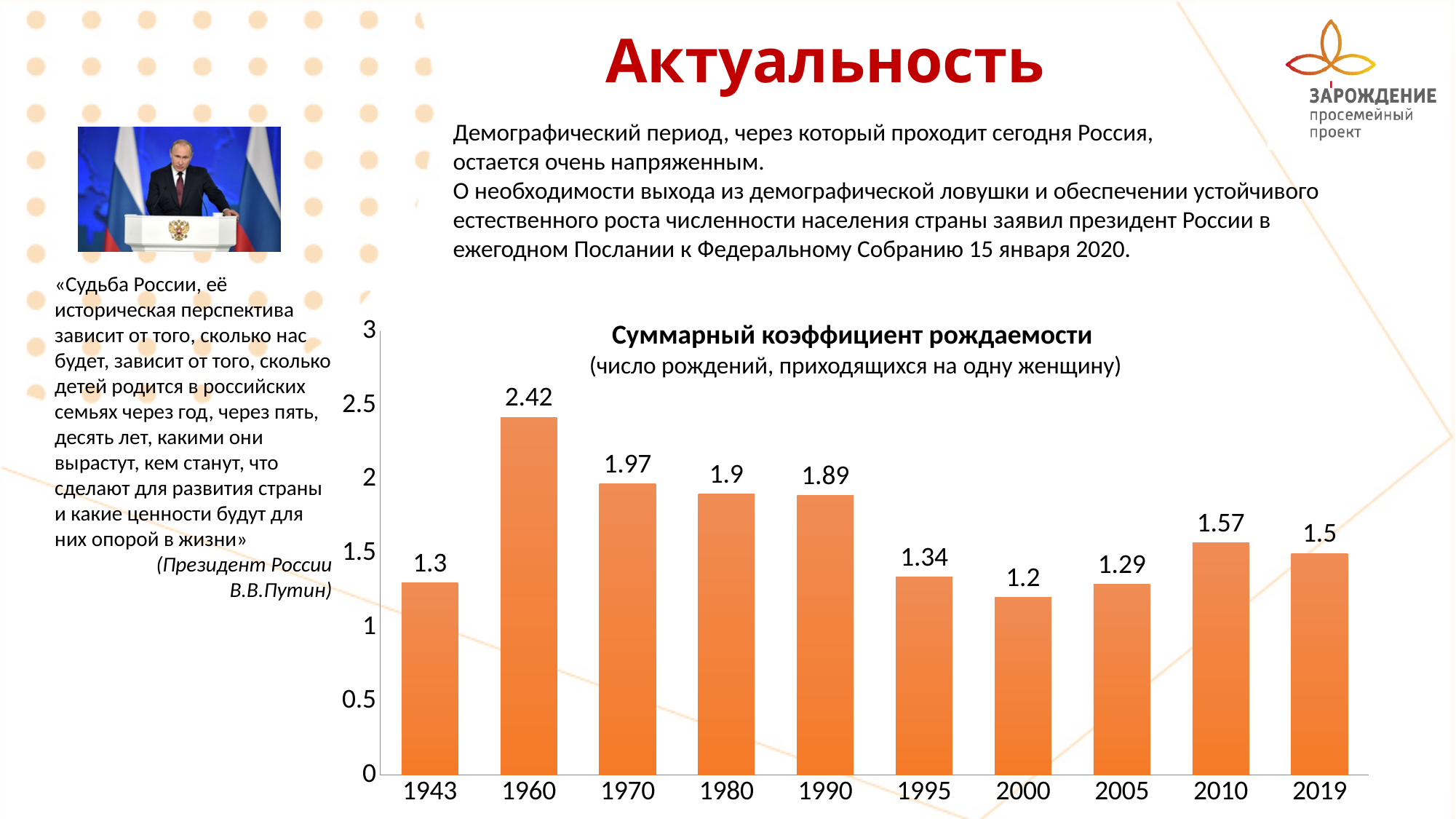
Which year has the larger value, 1970 or 1990? 1970 Which year has the highest total fertility rate? 1960 What value is shown for 2019 in the chart? 1.5 Which year has the lowest total fertility rate? 2000 What is the value for 1943? 1.3 What is the total fertility rate shown for 1960? 2.42 Do the values rise or fall from 1960 to 2000? Fall What is the difference between the values for 1960 and 2000? 1.22 How many years are shown on the x axis of the chart? 10 Is the value for 2010 greater or less than 1.5? greater What kind of chart is shown on the slide? Bar chart What is the title of the chart? Суммарный коэффициент рождаемости